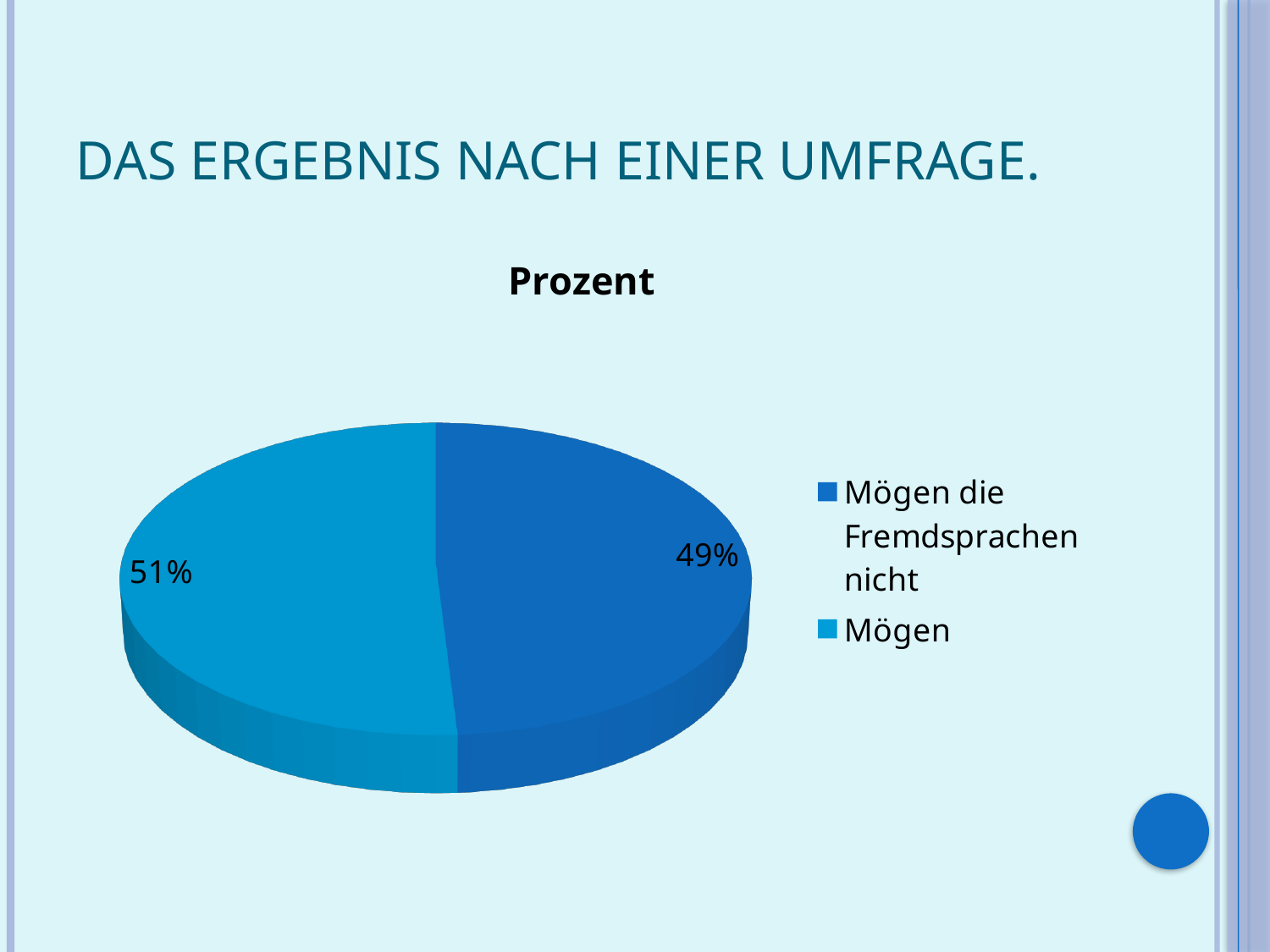
Which legend entry is shown in the darker blue colour? Mögen die Fremdsprachen nicht What percentage of the pie is labelled for "Mögen"? 51% Is the share for "Mögen" greater or less than 50%? greater What percentage of the pie is labelled for "Mögen die Fremdsprachen nicht"? 49% How many entries does the legend list? 2 Which category has the largest share of the pie? Mögen Which is larger: the share for "Mögen" or the share for "Mögen die Fremdsprachen nicht"? Mögen How many slices does the pie chart have? 2 What is the difference in percentage points between the "Mögen" slice and the "Mögen die Fremdsprachen nicht" slice? 2 percentage points What is the title of the chart? Prozent Which category has the smallest share of the pie? Mögen die Fremdsprachen nicht What kind of chart is shown on the slide? Pie chart